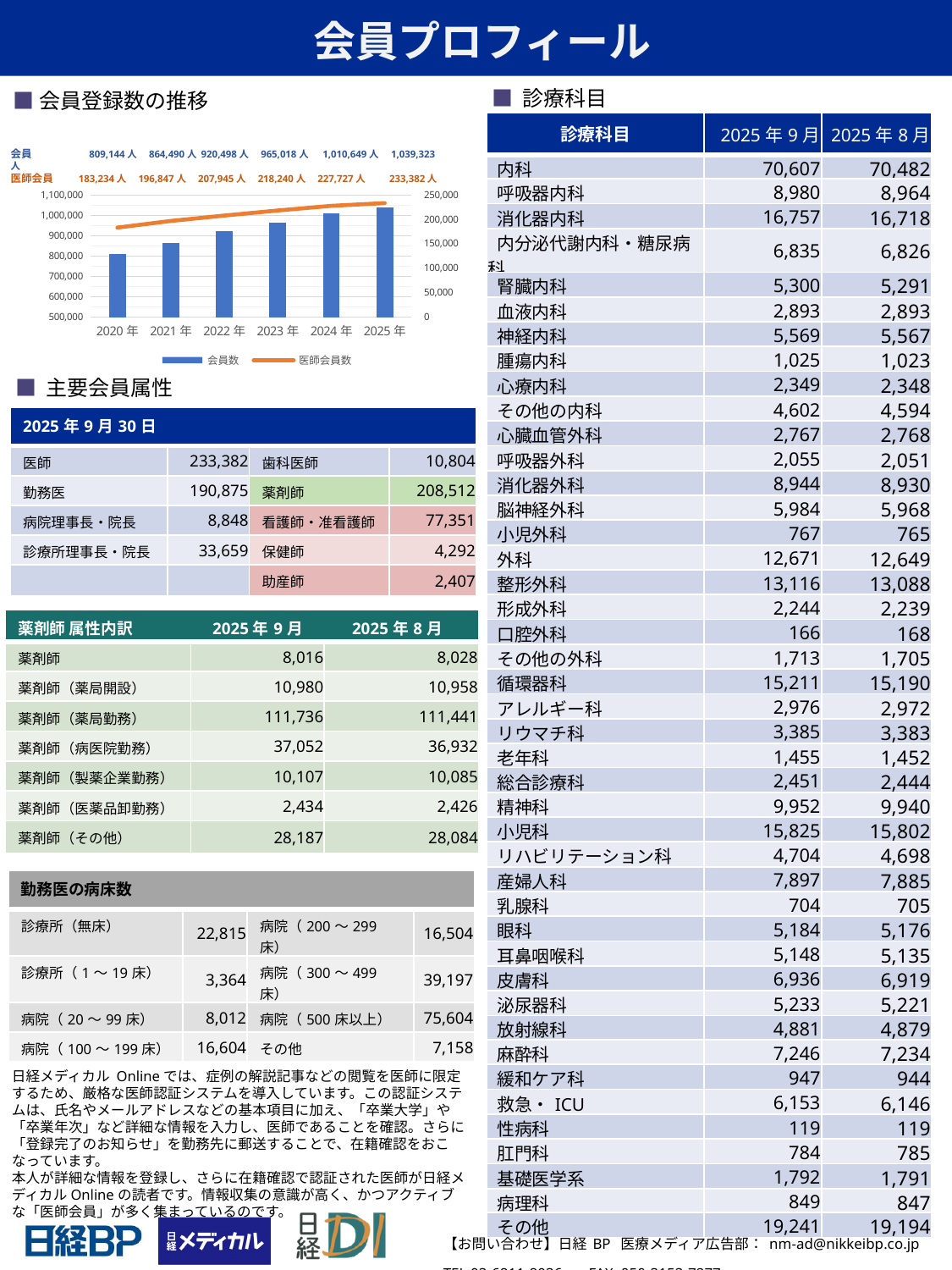
In the 会員登録数の推移 chart, what is the 医師会員数 value for 2024年? 227,727人 In the 会員登録数の推移 chart, is the 会員数 for 2020年 greater or less than 900,000? less In the 会員登録数の推移 chart, which year has the lowest 医師会員数? 2020年 In the 会員登録数の推移 chart, which year has the highest 会員数? 2025年 In the 会員登録数の推移 chart, what is the difference in 医師会員数 between 2025年 and 2020年? 50,148 How many series does the legend of the 会員登録数の推移 chart list? 2 In the 会員登録数の推移 chart, do the 会員数 values rise or fall from 2020年 to 2025年? rise In the 会員登録数の推移 chart, what is the 会員数 value for 2022年? 920,498人 In the 会員登録数の推移 chart, what is the 医師会員数 value for 2020年? 183,234人 In the 会員登録数の推移 chart, by how much did 会員数 increase from 2024年 to 2025年? 28,674 In the 会員登録数の推移 chart, what is the 会員数 value for 2025年? 1,039,323 How many years are shown on the x axis of the 会員登録数の推移 chart? 6